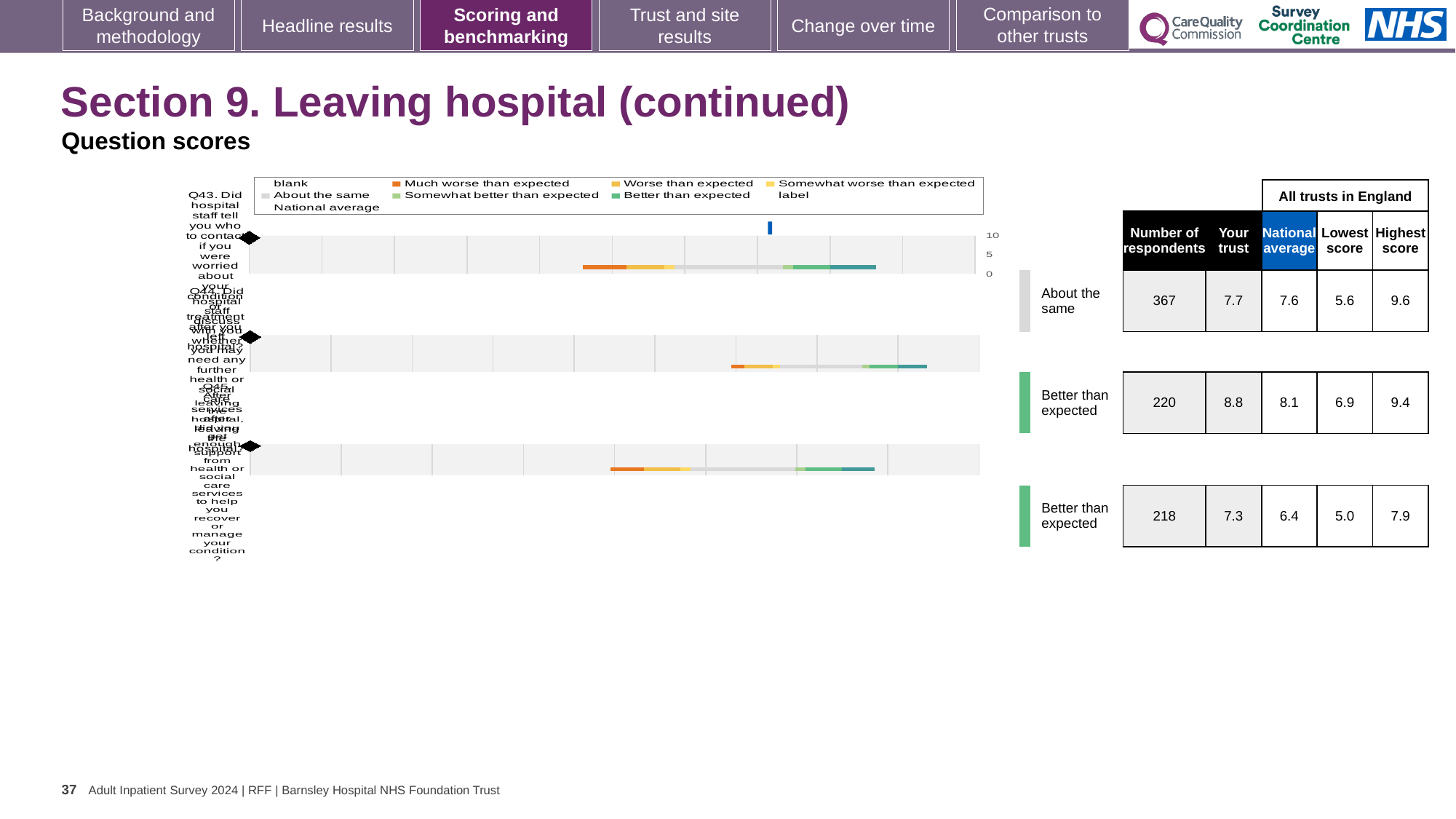
What is the 'Your trust' score for the first question row (367 respondents)? 7.7 What is the lowest score across all trusts in England for the first question row (367 respondents)? 5.6 How many question bars are plotted in the chart? 3 What is the national average for the second question row (220 respondents)? 8.1 Which question row has the highest 'Your trust' score? the second row (220 respondents) What is the difference between the 'Your trust' score and the national average for the second question row (220 respondents)? 0.7 What is the highest score across all trusts in England for the third question row (218 respondents)? 7.9 What benchmark category is shown for the first question row (367 respondents)? About the same What kind of chart is shown on the slide? bar chart Which question row has the lowest national average? the third row (218 respondents) Is the 'Your trust' score for the third question row (218 respondents) larger or smaller than its national average? larger What benchmark category is shown for the second question row (220 respondents)? Better than expected